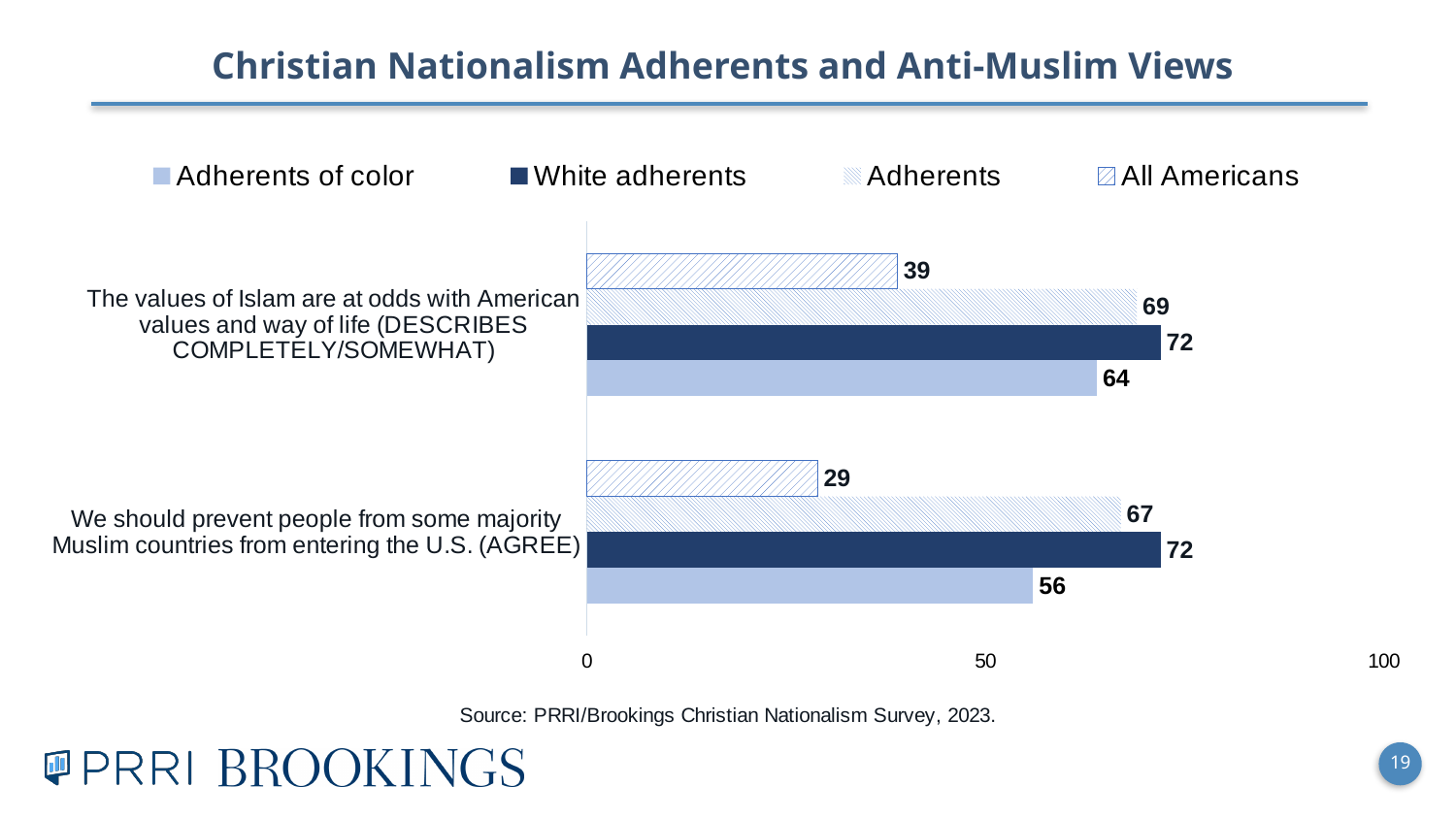
How many statements (categories) are shown on the chart? 2 What is the difference between White adherents and All Americans on "We should prevent people from some majority Muslim countries from entering the U.S."? 43 How many series does the legend list? 4 What is the value for All Americans on "We should prevent people from some majority Muslim countries from entering the U.S."? 29 What is the value for Adherents of color on "We should prevent people from some majority Muslim countries from entering the U.S."? 56 Which is larger: Adherents of color on "The values of Islam are at odds with American values" or Adherents of color on "We should prevent people from some majority Muslim countries from entering the U.S."? The values of Islam are at odds with American values What kind of chart is shown on the slide? Bar chart Which series has the lowest value on "The values of Islam are at odds with American values and way of life"? All Americans Which series has the highest value on "We should prevent people from some majority Muslim countries from entering the U.S."? White adherents What is the difference between Adherents of color on the two statements (Islam values vs. preventing entry from majority Muslim countries)? 8 What is the value for White adherents on "The values of Islam are at odds with American values and way of life"? 72 What is the value for Adherents on "The values of Islam are at odds with American values and way of life"? 69